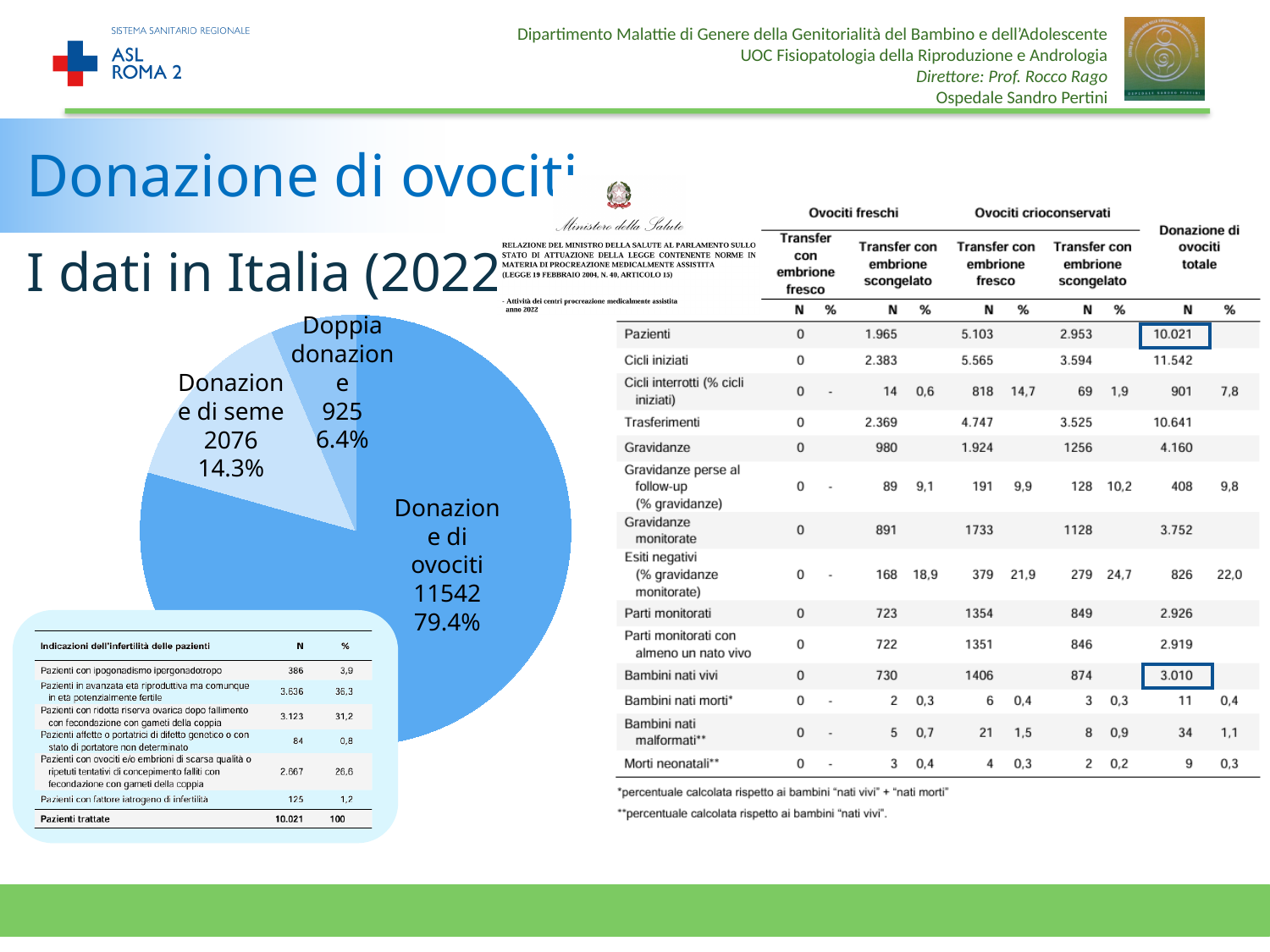
Which slice of the pie chart is the smallest? Doppia donazione What is the value shown for Doppia donazione in the pie chart? 925 Which is larger in the pie chart, Donazione di seme or Doppia donazione? Donazione di seme What is the value shown for Donazione di seme in the pie chart? 2076 What kind of chart is shown on the slide? pie chart How many slices does the pie chart have? 3 What is the value shown for Donazione di ovociti in the pie chart? 11542 What percentage share of the pie does Donazione di ovociti represent? 79.4% Which slice of the pie chart is the largest? Donazione di ovociti What percentage share of the pie does Donazione di seme represent? 14.3% What percentage share of the pie does Doppia donazione represent? 6.4% What is the difference between the values for Donazione di seme and Doppia donazione in the pie chart? 1151